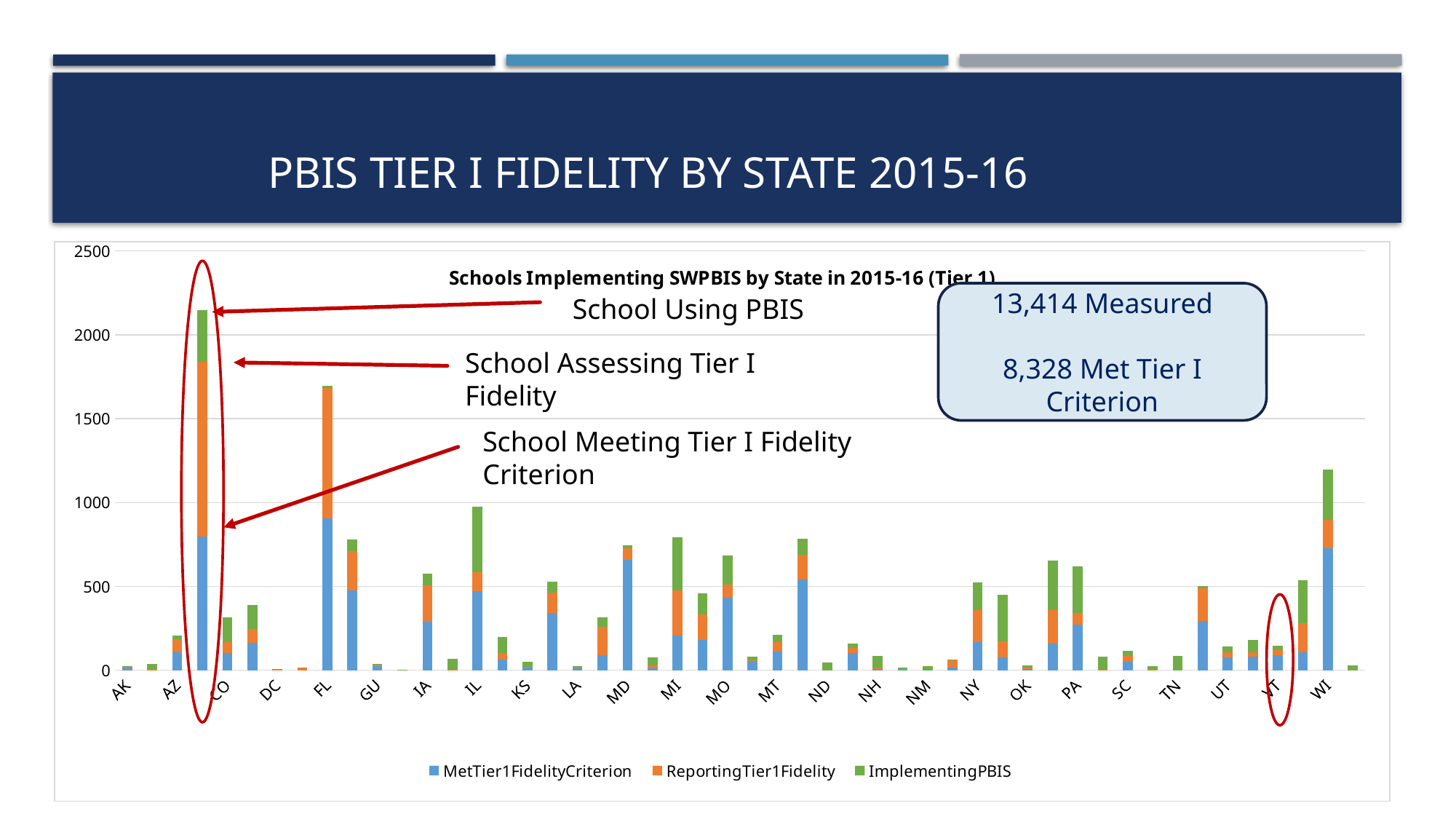
What is the title of the chart? Schools Implementing SWPBIS by State in 2015-16 (Tier 1) Which state has the taller bar, FL or WI? FL Which state has the taller bar, PA or NM? PA How many series does the chart legend list? 3 Is the total value of the bar for WI greater or less than 1000? greater Is the total value of the bar for MD greater or less than 500? greater Which series is shown in green in the chart legend? ImplementingPBIS Is the total value of the bar for VT greater or less than 500? less What kind of chart is shown on the slide? stacked bar chart Which state has the taller bar, MI or MT? MI